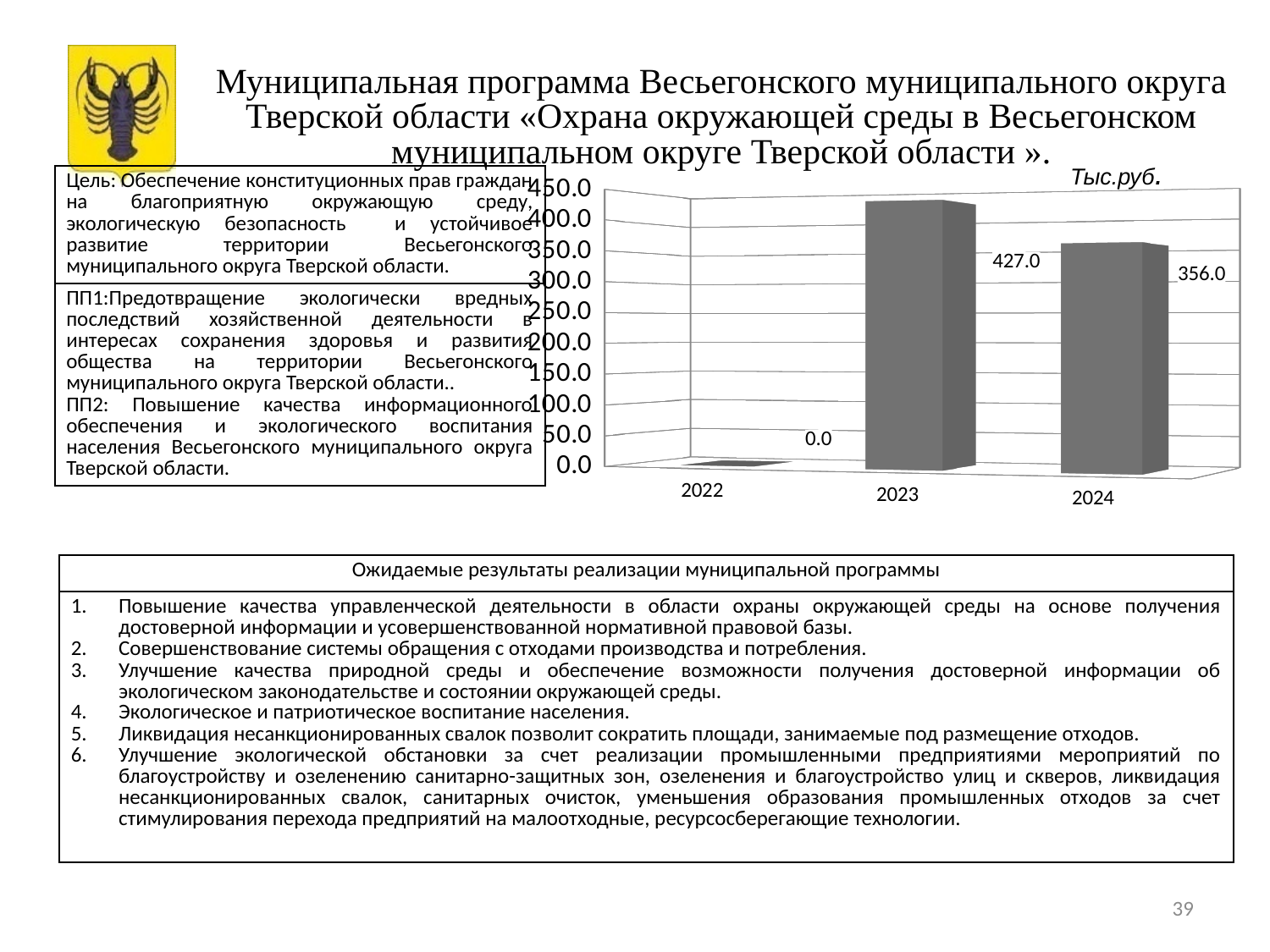
What kind of chart is shown on the slide? bar chart What is the value for 2023? 427.0 What is the value for 2022? 0.0 What is the value for 2024? 356.0 How many years are shown on the x axis of the chart? 3 Which is larger, the value for 2023 or the value for 2024? 2023 Does the value rise or fall from 2023 to 2024? fall Which year has the lowest value? 2022 What is the difference between the values for 2023 and 2024? 71.0 What unit label is shown above the chart? Тыс.руб. Which year has the highest value? 2023 Is the value for 2024 greater or less than 300.0? greater